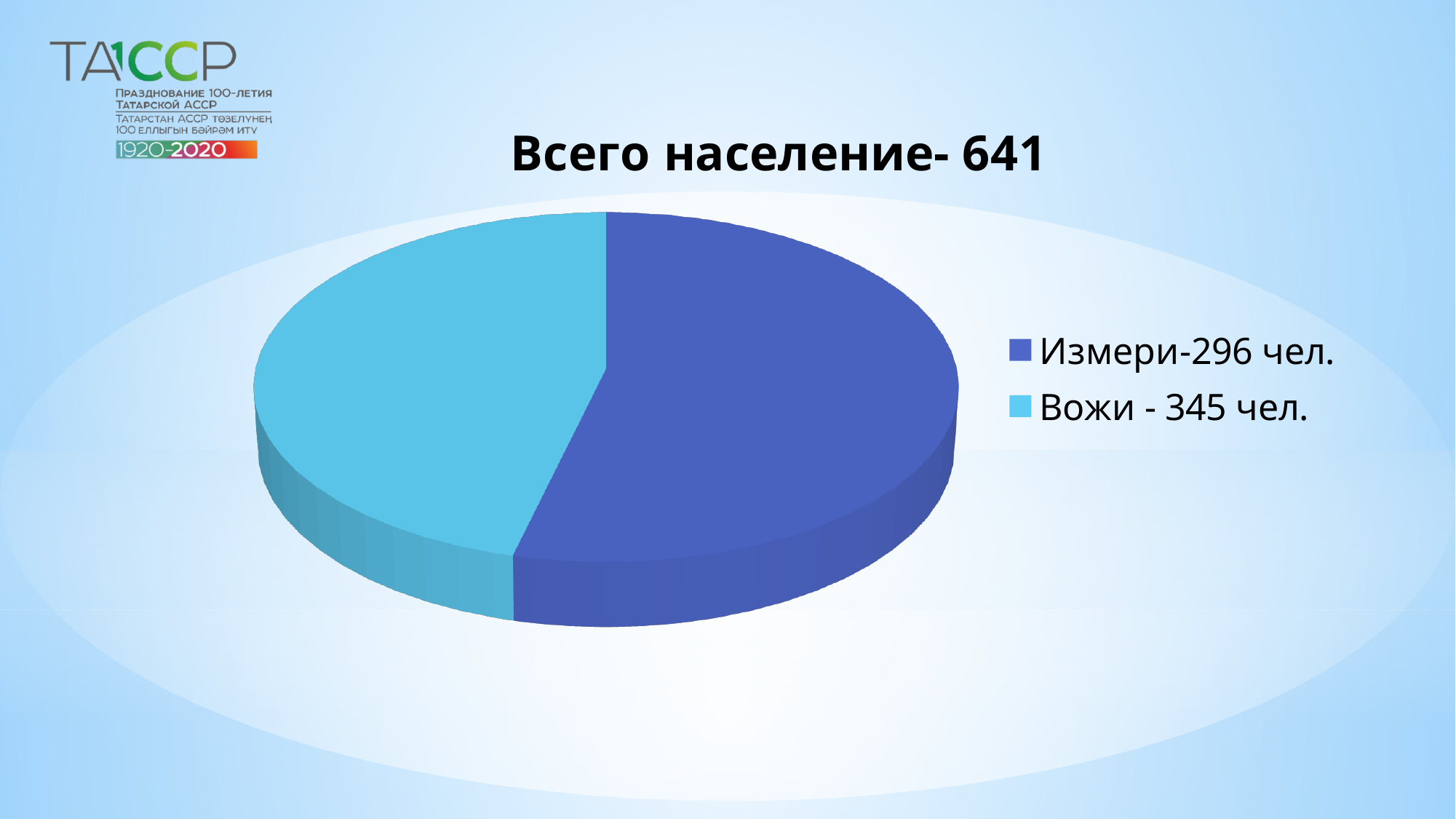
What is the population value for Вожи? 345 чел. What kind of chart is shown on the slide? pie chart How many slices does the pie chart have? 2 Which colour represents Вожи in the pie chart? light blue How many entries does the legend list? 2 Which slice is the largest? Измери What is the population value for Измери? 296 чел. What is the total population shown in the chart title? 641 Which has a larger population, Измери or Вожи? Вожи Which slice is the smallest? Вожи What is the difference between the population of Вожи and Измери? 49 What is the title of the chart? Всего население- 641